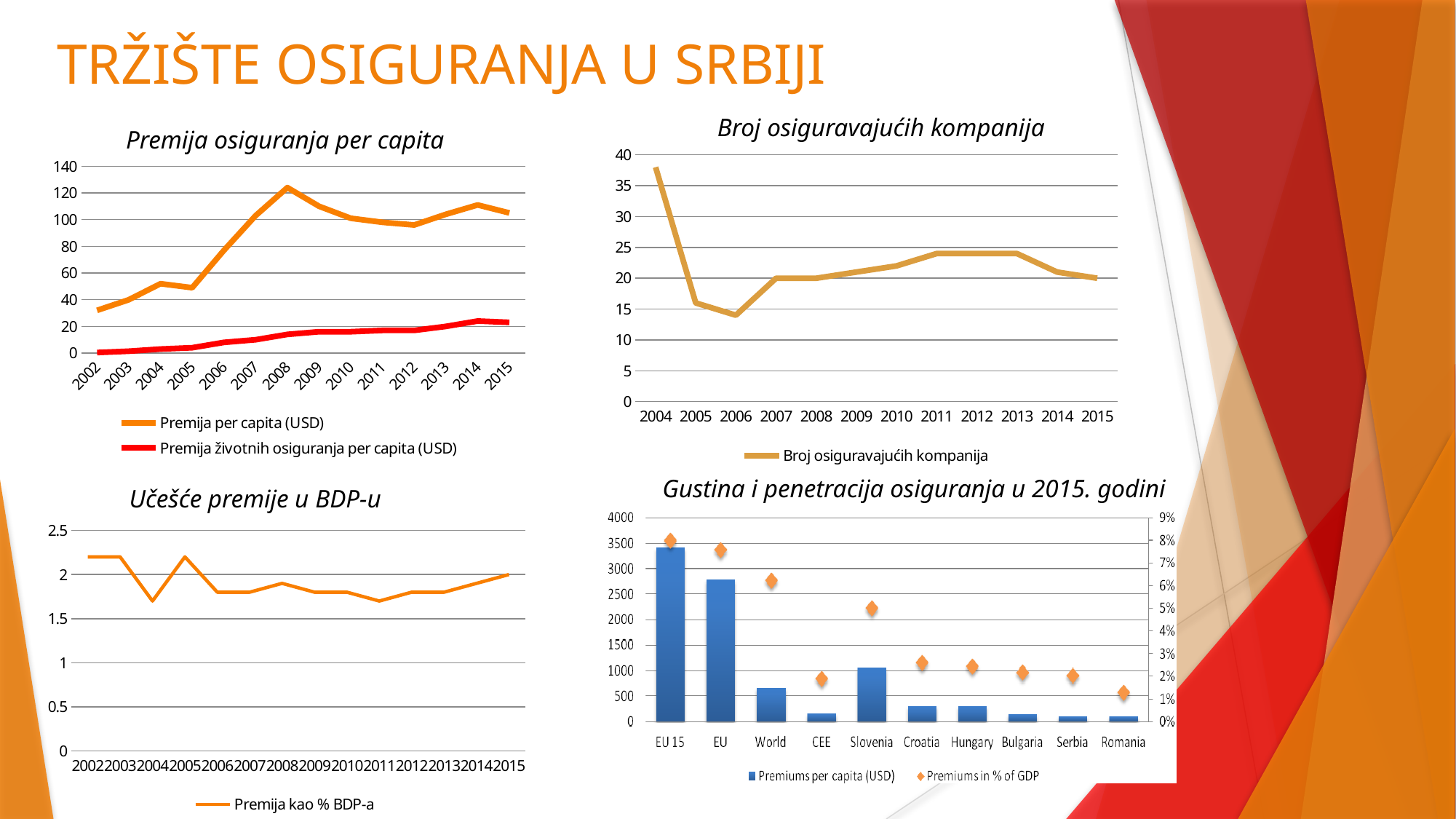
In the 'Gustina i penetracija osiguranja u 2015. godini' chart, how many categories are shown on the x axis? 10 In the 'Premija osiguranja per capita' chart, which year has the highest value for 'Premija per capita (USD)'? 2008 In the 'Premija osiguranja per capita' chart, which series is drawn in red? Premija životnih osiguranja per capita (USD) In the 'Učešće premije u BDP-u' chart, is the value for 2004 greater or less than 2? less In the 'Premija osiguranja per capita' chart, is the 2002 value for 'Premija per capita (USD)' greater or less than 40? less In the 'Gustina i penetracija osiguranja u 2015. godini' chart, which category has the highest 'Premiums per capita (USD)' bar? EU 15 In the 'Broj osiguravajućih kompanija' chart, which year has the lowest value? 2006 In the 'Broj osiguravajućih kompanija' chart, how many years are plotted on the x axis? 12 In the 'Broj osiguravajućih kompanija' chart, is the value for 2004 greater or less than 35? greater What kind of chart is 'Učešće premije u BDP-u'? line chart In the 'Premija osiguranja per capita' chart, how many series does the legend list? 2 In the 'Broj osiguravajućih kompanija' chart, is the value for 2004 larger or smaller than the value for 2015? larger